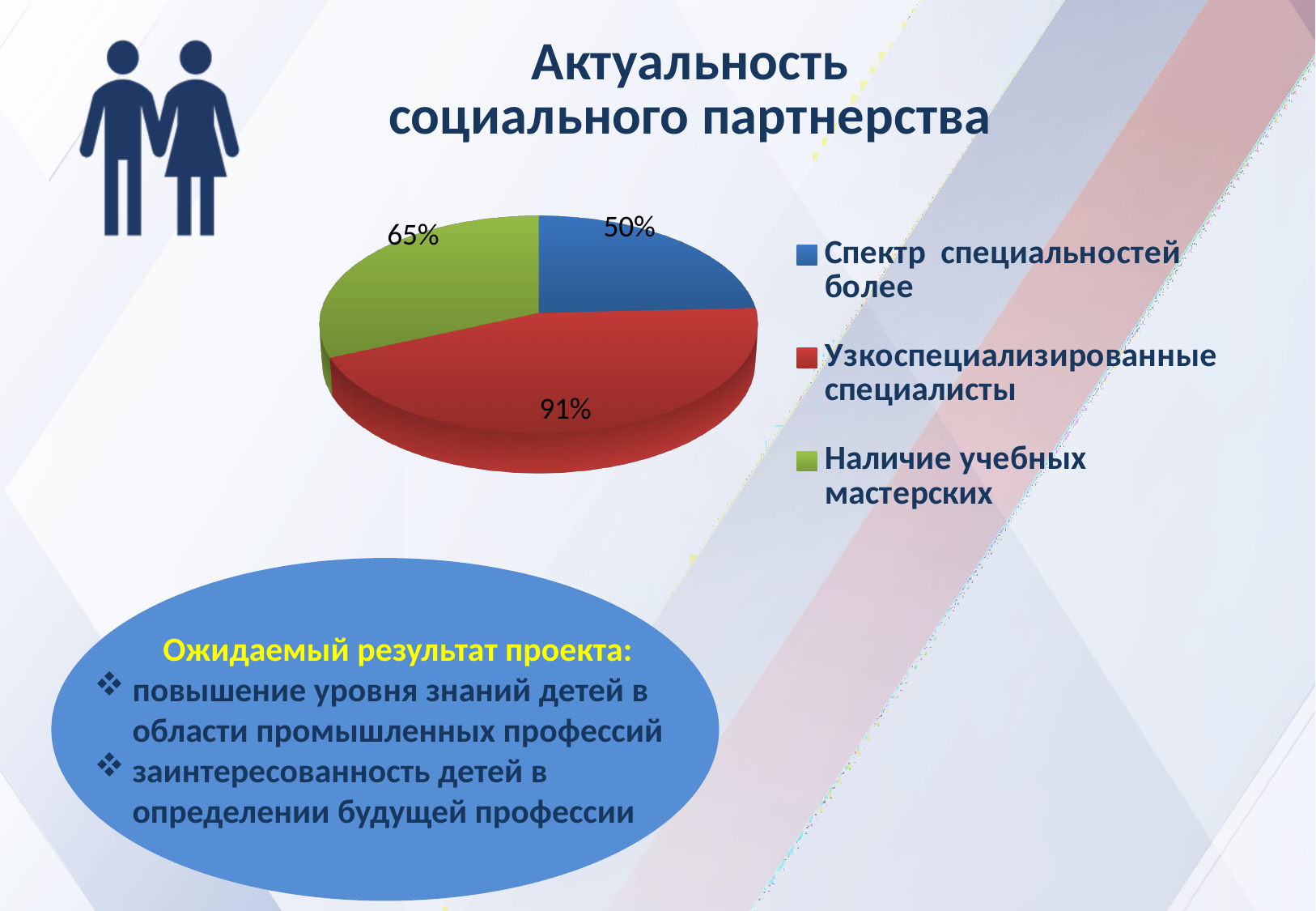
How many slices does the pie chart have? 3 What value is shown for "Узкоспециализированные специалисты"? 91% Which category has the lowest value in the pie chart? Спектр специальностей более What value is shown for "Наличие учебных мастерских"? 65% What colour is the slice for "Наличие учебных мастерских"? Green Which category has the highest value in the pie chart? Узкоспециализированные специалисты What kind of chart is shown on the slide? Pie chart What is the difference between the values for "Наличие учебных мастерских" and "Спектр специальностей более"? 15% How many entries does the legend list? 3 What is the difference between the values for "Узкоспециализированные специалисты" and "Наличие учебных мастерских"? 26% Which is larger: the value for "Наличие учебных мастерских" or the value for "Спектр специальностей более"? Наличие учебных мастерских What value is shown for "Спектр специальностей более"? 50%